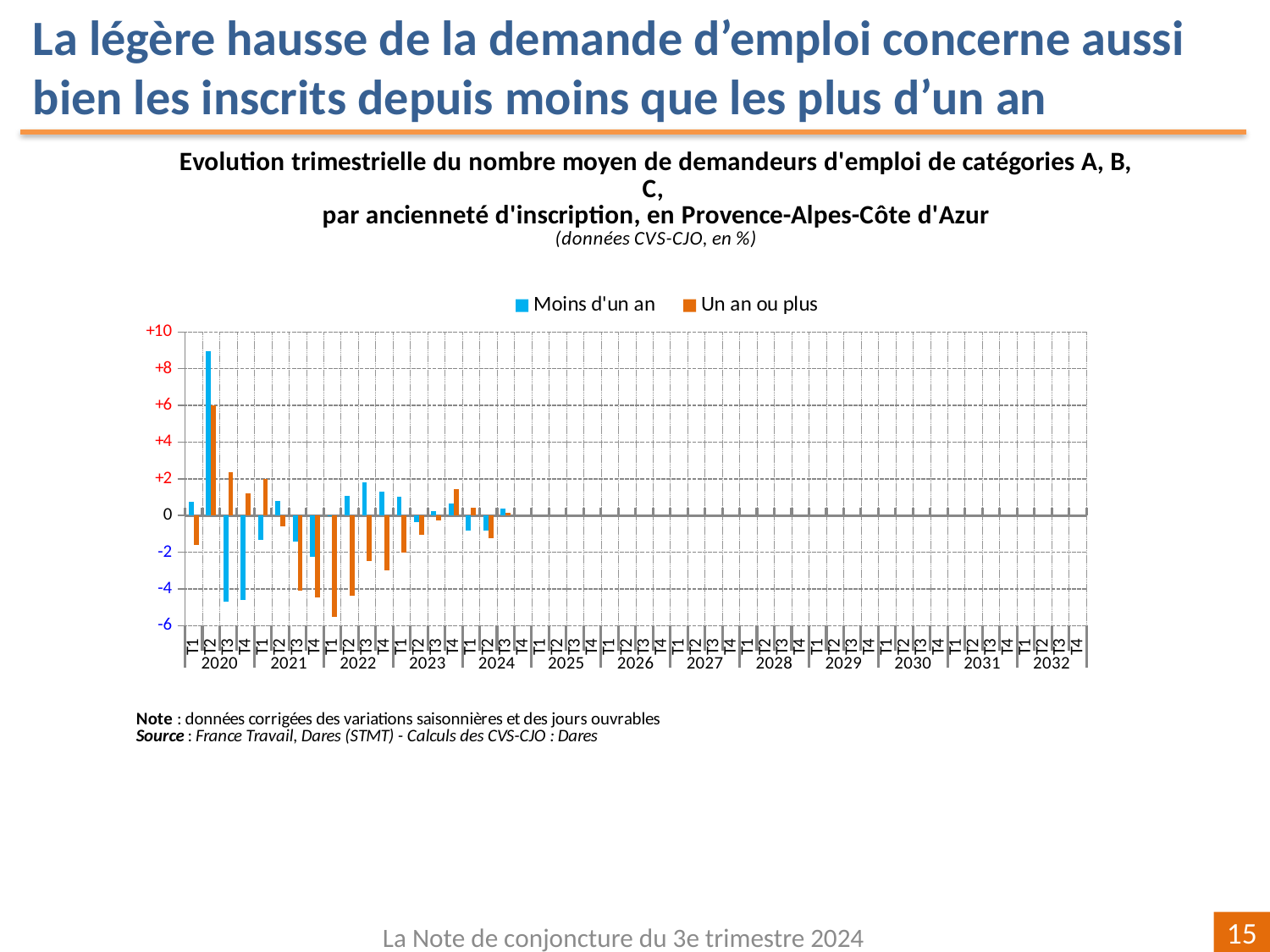
In T2 2020, which series has the larger value, 'Moins d'un an' or 'Un an ou plus'? Moins d'un an In which quarter is the value for 'Un an ou plus' highest? T2 2020 Is the value for 'Moins d'un an' in T2 2020 greater or less than +8? greater In which quarter is the value for 'Moins d'un an' highest? T2 2020 Which colour represents the series 'Moins d'un an'? blue In T3 2020, which series has the larger value, 'Moins d'un an' or 'Un an ou plus'? Un an ou plus What are the two series named in the legend? Moins d'un an; Un an ou plus How many series does the legend list? 2 What kind of chart is shown on the slide? bar chart Is the value for 'Moins d'un an' in T3 2020 greater or less than -4? less How many years are labelled along the x axis? 13 Is the value for 'Un an ou plus' in T2 2020 greater or less than +4? greater